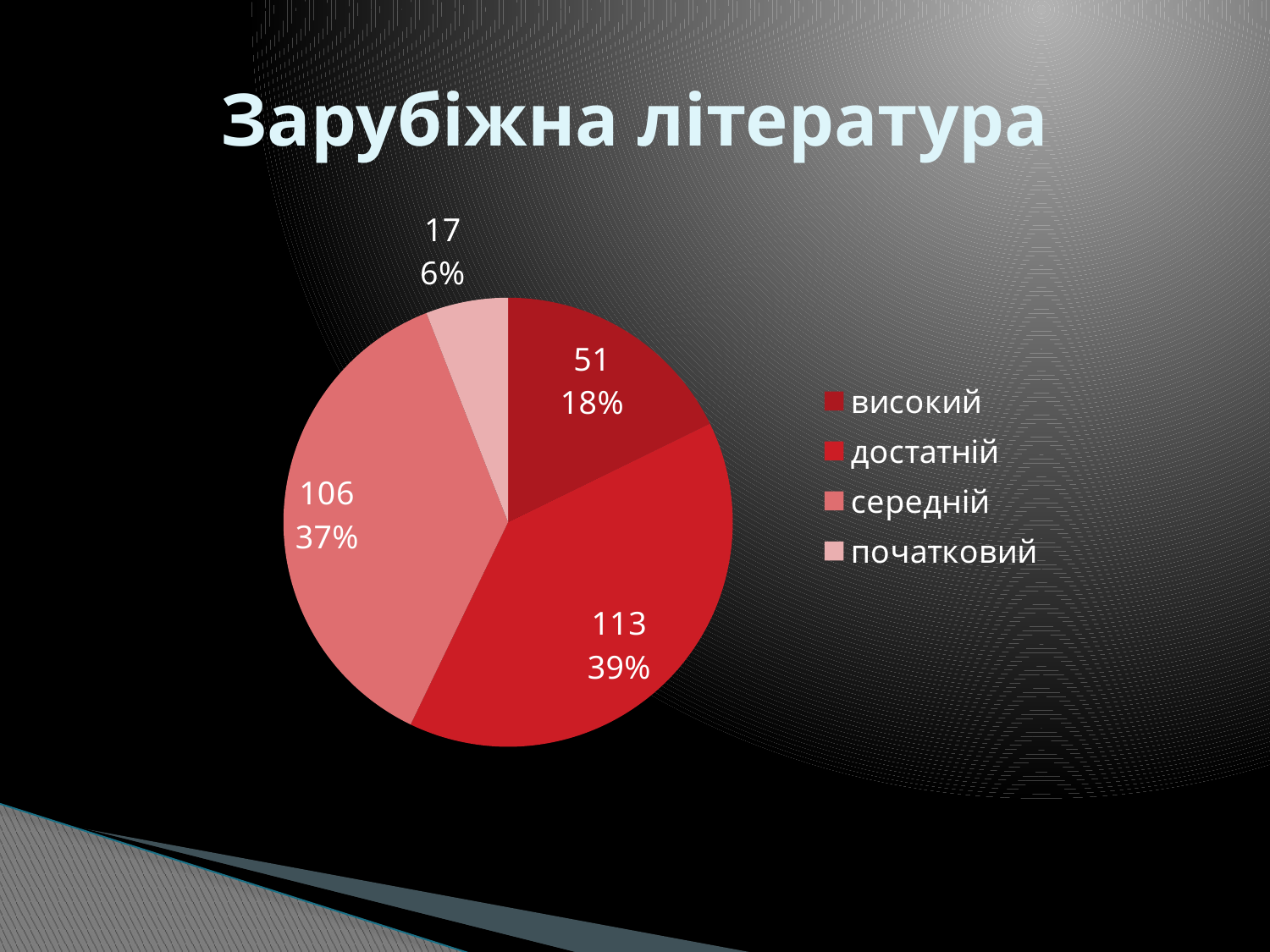
What is the difference between the values for "високий" and "початковий"? 34 Which is larger, the value for "високий" or the value for "початковий"? високий What is the title of the slide containing the chart? Зарубіжна література What is the value for the "достатній" slice? 113 Which category has the smallest slice? початковий What percentage share does the "початковий" slice have? 6% Which category has the largest slice? достатній What is the value for the "високий" slice? 51 What is the difference between the values for "достатній" and "середній"? 7 What percentage share does the "середній" slice have? 37% How many categories does the pie chart have? 4 What kind of chart is shown on the slide? pie chart